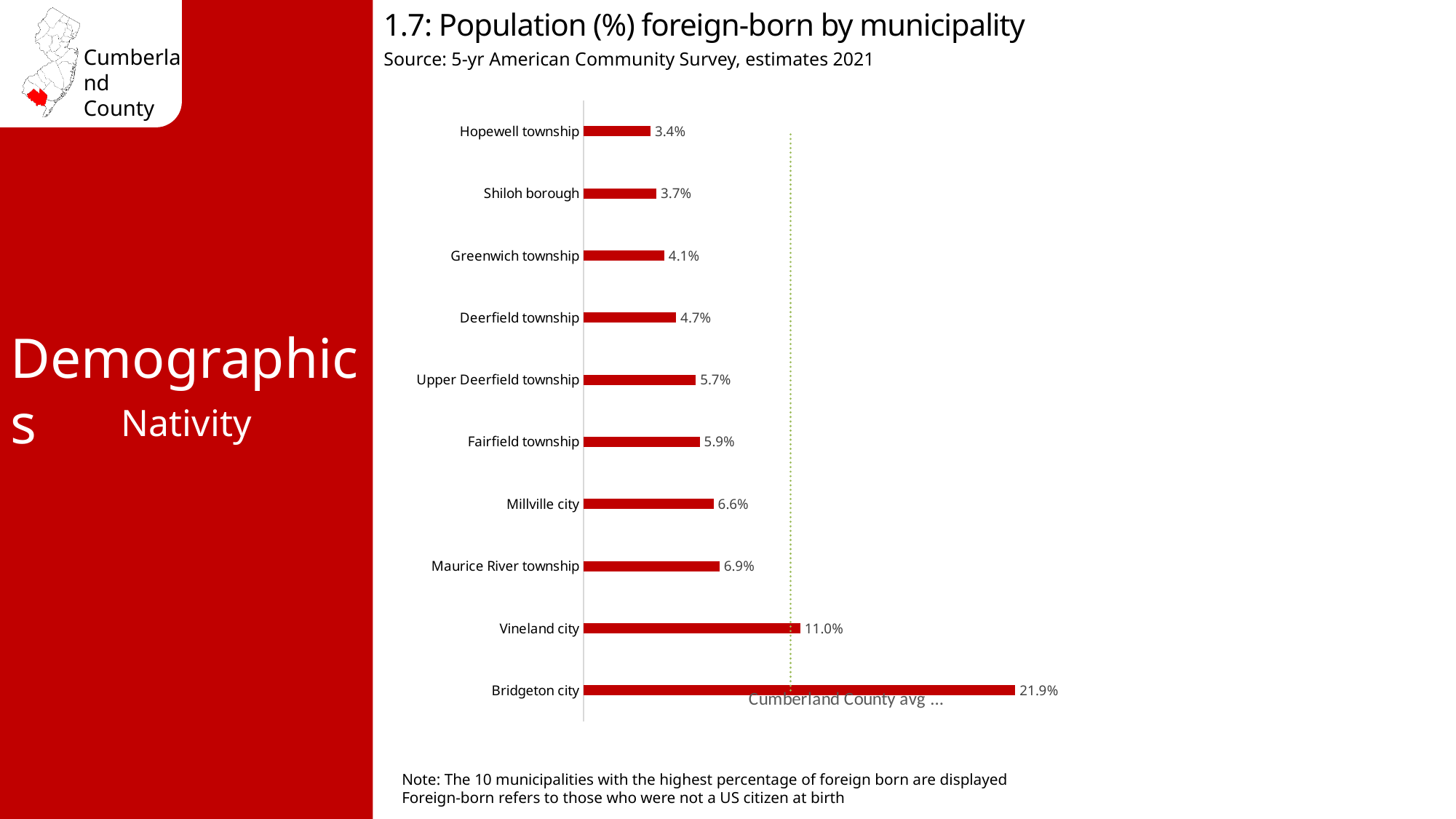
What kind of chart is used to show the foreign-born population by municipality? Bar chart What is the foreign-born population percentage for Vineland city? 11.0% What is the difference in foreign-born percentage between Maurice River township and Millville city? 0.3% What is the title of the chart? 1.7: Population (%) foreign-born by municipality What is the difference in foreign-born percentage between Bridgeton city and Vineland city? 10.9% Which municipality has the highest foreign-born population percentage? Bridgeton city What does the dotted vertical line on the chart represent? Cumberland County avg What is the foreign-born population percentage for Upper Deerfield township? 5.7% What is the foreign-born population percentage for Bridgeton city? 21.9% How many municipalities are shown in the chart? 10 Which municipality has the lowest foreign-born population percentage shown? Hopewell township Which has a higher foreign-born percentage, Fairfield township or Deerfield township? Fairfield township